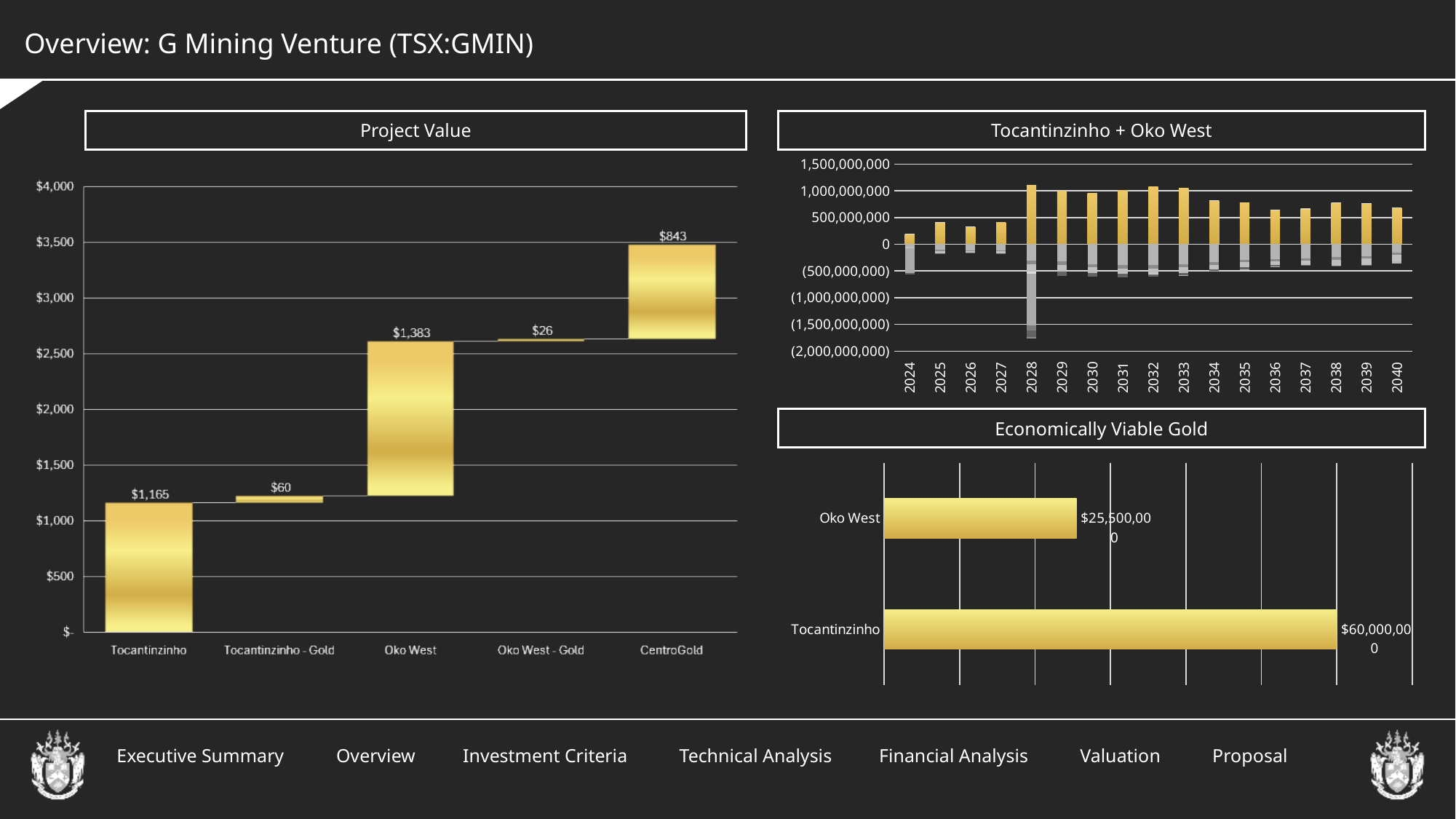
How many years are shown on the x axis of the Tocantinzinho + Oko West chart? 17 In the Economically Viable Gold chart, what is the value shown for Tocantinzinho? $60,000,000 In the Project Value chart, what is the value shown for Oko West? $1,383 In the Project Value chart, what is the difference between the Oko West value and the Tocantinzinho value? $218 In the Project Value chart, what is the value shown for CentroGold? $843 In the Tocantinzinho + Oko West chart, is the positive (gold) value for 2024 greater or less than 500,000,000? less In the Project Value chart, which category has the lowest value? Oko West - Gold In the Economically Viable Gold chart, what is the difference between the Tocantinzinho value and the Oko West value? $34,500,000 In the Project Value chart, what is the value shown for Tocantinzinho? $1,165 How many categories are shown on the x axis of the Project Value chart? 5 In the Project Value chart, which category has the highest value? Oko West What kind of chart is the Project Value chart? Bar chart